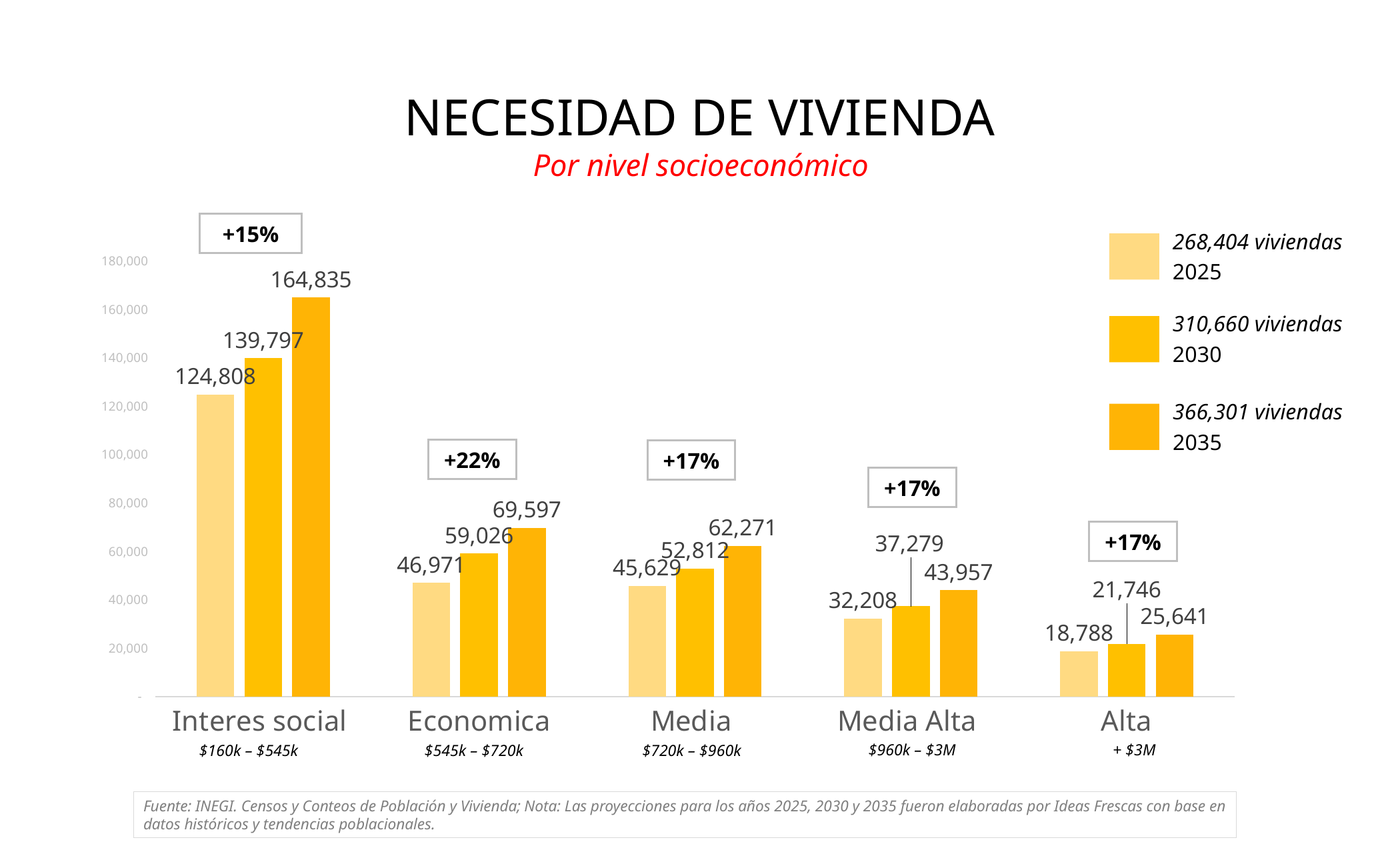
What is the difference between the 2035 and 2025 values for Interes social? 40,027 What is the value for Interes social in 2035? 164,835 What is the value for Alta in 2025? 18,788 Which is larger in 2035: Economica or Media? Economica What kind of chart is shown on the slide? Bar chart What is the value for Media Alta in 2035? 43,957 Which category has the highest value in 2025? Interes social Which category has the lowest value in 2035? Alta How many socioeconomic categories are shown on the x axis? 5 How many series does the legend list? 3 What is the value for Economica in 2030? 59,026 What percentage label is shown above the Economica group? +22%